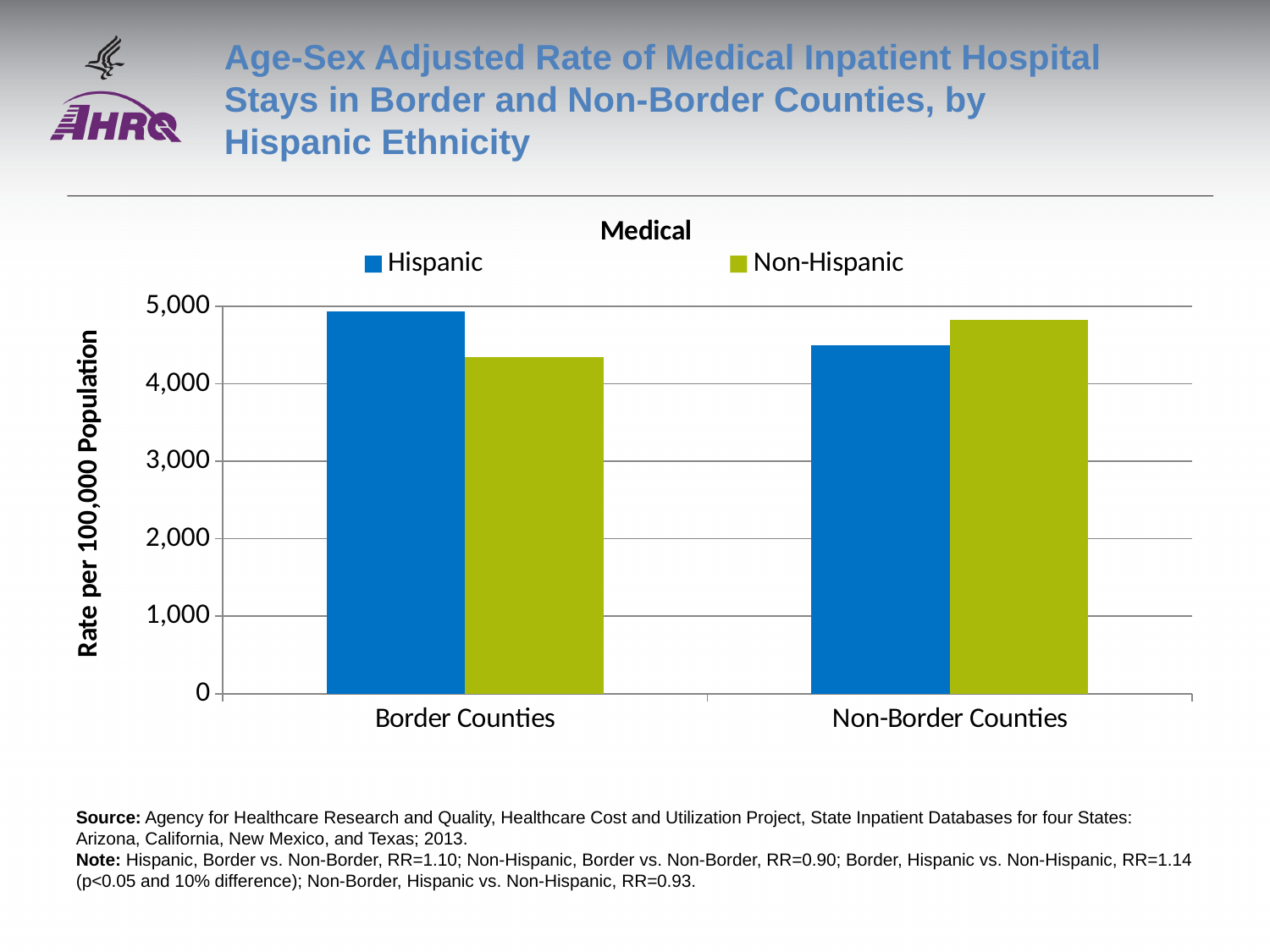
Is the value for Hispanic in Non-Border Counties greater or less than 4,000? greater What kind of chart is shown on the slide? bar chart For the Non-Hispanic series, which county category has the lower rate? Border Counties Is the value for Hispanic in Border Counties greater or less than 4,000? greater What is the label on the y axis of the chart? Rate per 100,000 Population In Non-Border Counties, which is larger, the Hispanic or the Non-Hispanic rate? Non-Hispanic For the Hispanic series, which county category has the higher rate? Border Counties Is the value for Non-Hispanic in Non-Border Counties greater or less than 5,000? less In Border Counties, which is larger, the Hispanic or the Non-Hispanic rate? Hispanic How many series does the legend list? 2 How many county categories are shown on the x axis? 2